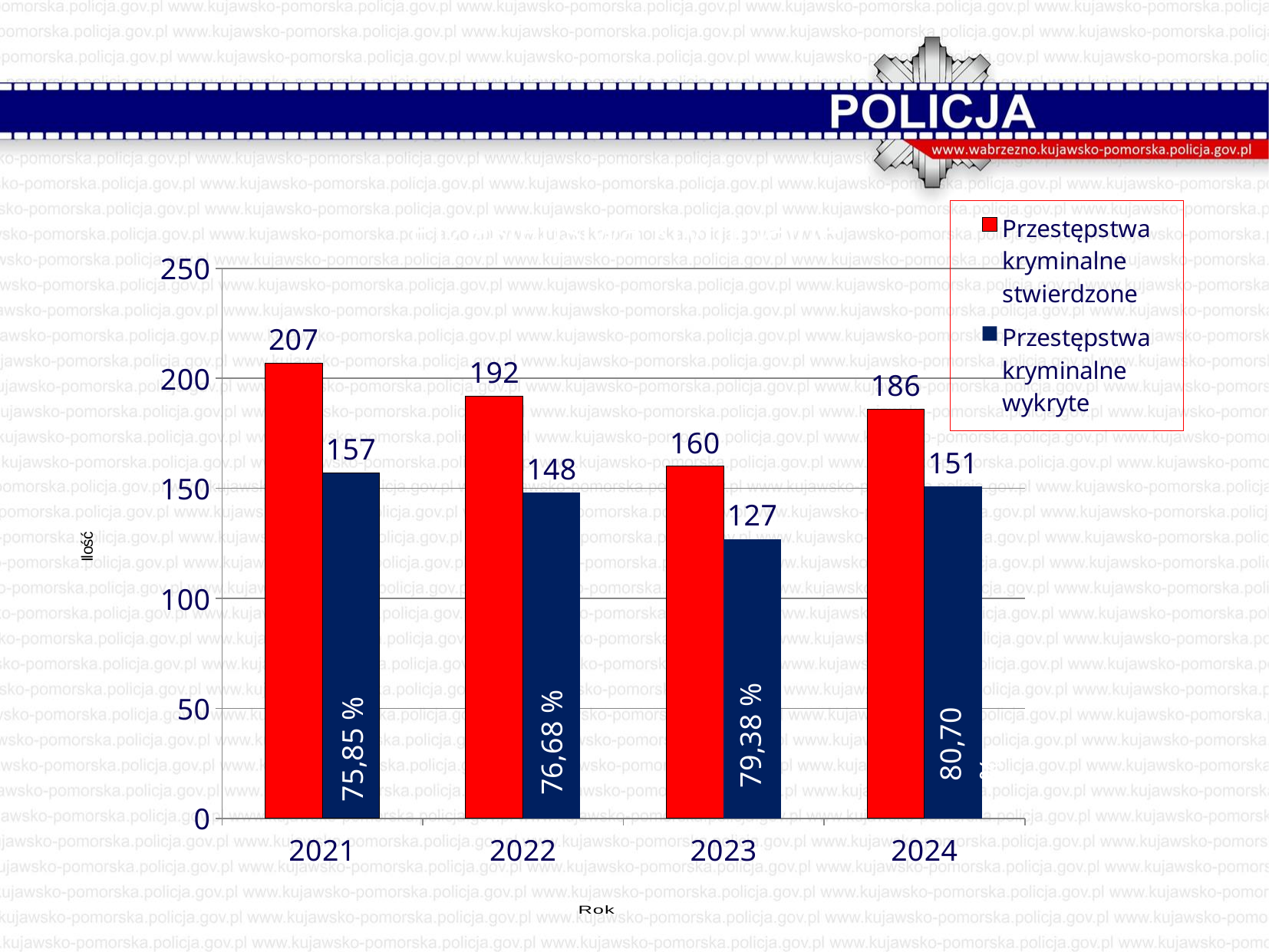
How many years are shown on the x axis? 4 Is the value of Przestępstwa kryminalne stwierdzone for 2024 greater or less than 200? less What is the value of Przestępstwa kryminalne stwierdzone for 2021? 207 What is the value of Przestępstwa kryminalne wykryte for 2023? 127 How many series does the legend list? 2 In which year is Przestępstwa kryminalne stwierdzone highest? 2021 What percentage label is printed inside the Przestępstwa kryminalne wykryte bar for 2023? 79,38 % In which year is Przestępstwa kryminalne wykryte lowest? 2023 What kind of chart is shown on the slide? bar chart What is the difference between Przestępstwa kryminalne stwierdzone and Przestępstwa kryminalne wykryte in 2022? 44 What is the value of Przestępstwa kryminalne wykryte for 2024? 151 Which is larger: Przestępstwa kryminalne stwierdzone in 2023 or Przestępstwa kryminalne wykryte in 2021? Przestępstwa kryminalne stwierdzone in 2023